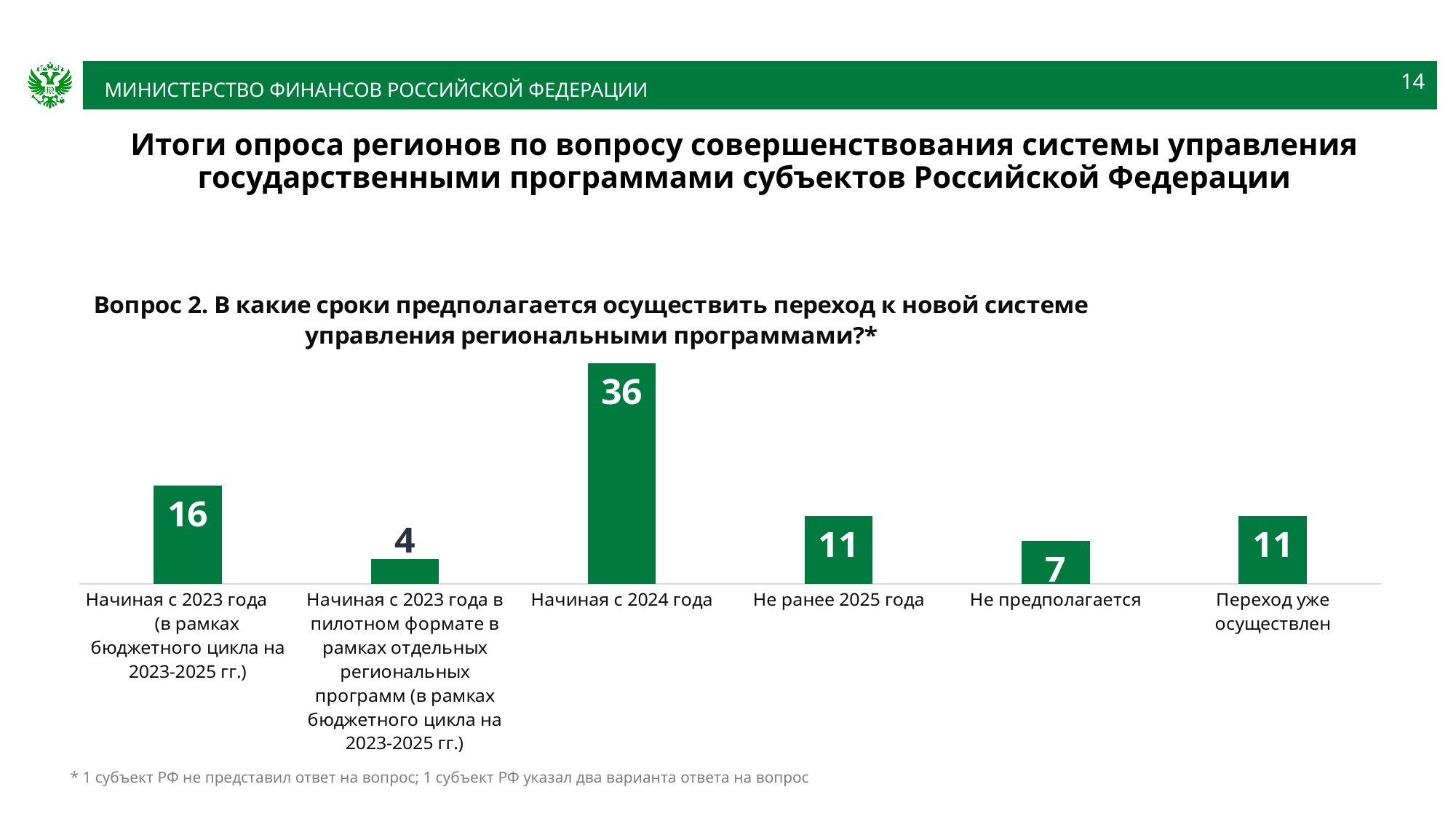
Which category has the lowest value? Начиная с 2023 года в пилотном формате в рамках отдельных региональных программ (в рамках бюджетного цикла на 2023-2025 гг.) What is the value for "Начиная с 2024 года"? 36 What is the title of the chart? Вопрос 2. В какие сроки предполагается осуществить переход к новой системе управления региональными программами?* What is the value for "Переход уже осуществлен"? 11 What is the difference between the values for "Начиная с 2024 года" and "Начиная с 2023 года (в рамках бюджетного цикла на 2023-2025 гг.)"? 20 How many categories are shown in the chart? 6 Which category has the highest value? Начиная с 2024 года What is the value for "Начиная с 2023 года (в рамках бюджетного цикла на 2023-2025 гг.)"? 16 What is the value for "Не предполагается"? 7 What kind of chart is shown on the slide? Bar chart What is the difference between the values for "Не ранее 2025 года" and "Не предполагается"? 4 Which is larger: the value for "Начиная с 2023 года (в рамках бюджетного цикла на 2023-2025 гг.)" or the value for "Не ранее 2025 года"? Начиная с 2023 года (в рамках бюджетного цикла на 2023-2025 гг.)